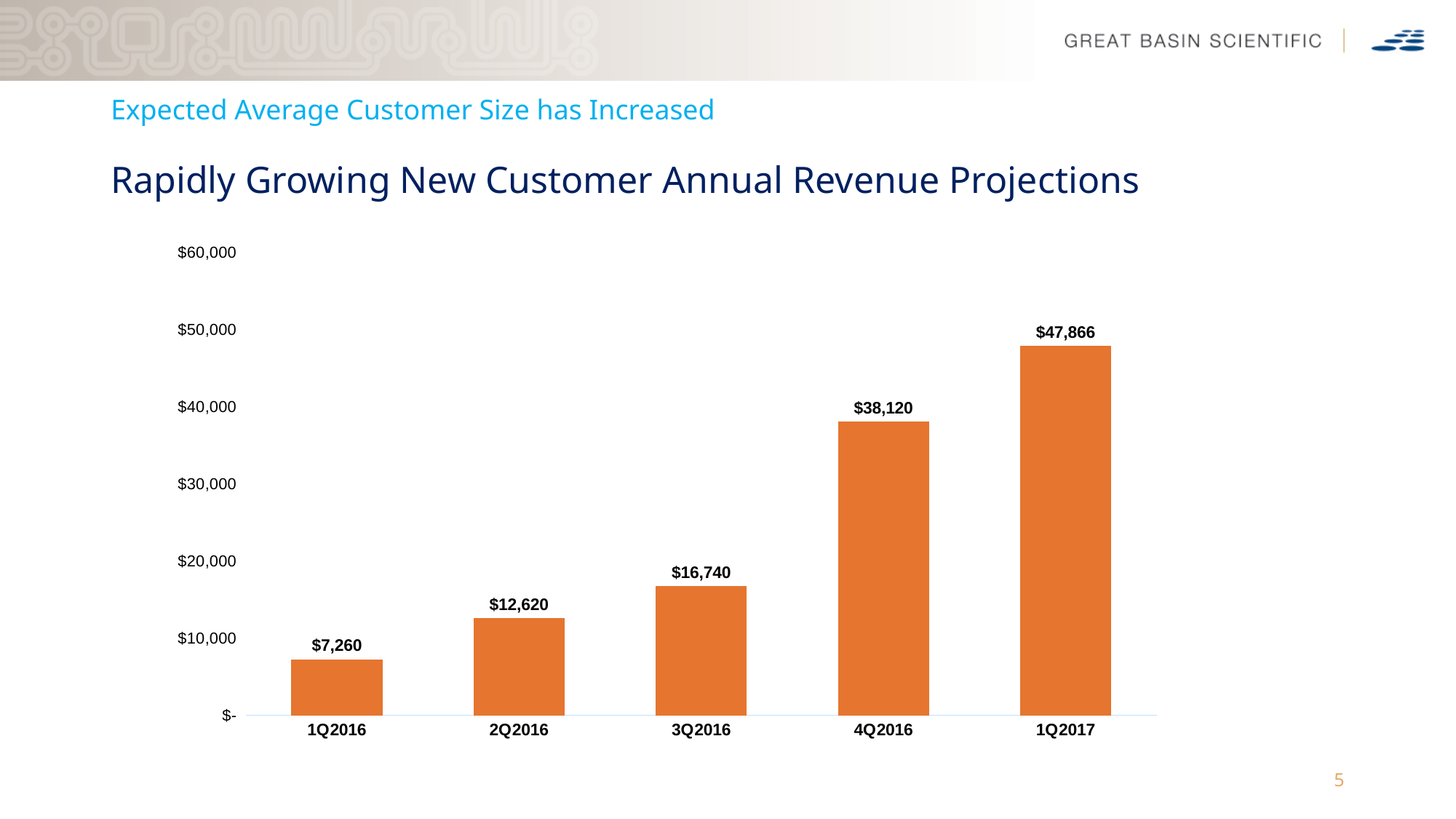
How many quarters are shown on the x axis? 5 What is the difference between the values for 4Q2016 and 3Q2016? $21,380 Is the value for 4Q2016 greater or less than $40,000? less Which quarter has the lowest value? 1Q2016 Which is larger, the value for 2Q2016 or the value for 3Q2016? 3Q2016 What is the difference between the values for 2Q2016 and 1Q2016? $5,360 What is the value for 1Q2017? $47,866 What kind of chart is shown on the slide? bar chart What is the value for 3Q2016? $16,740 Do the values rise or fall from 1Q2016 to 1Q2017? rise Which quarter has the highest value? 1Q2017 What is the value for 1Q2016? $7,260